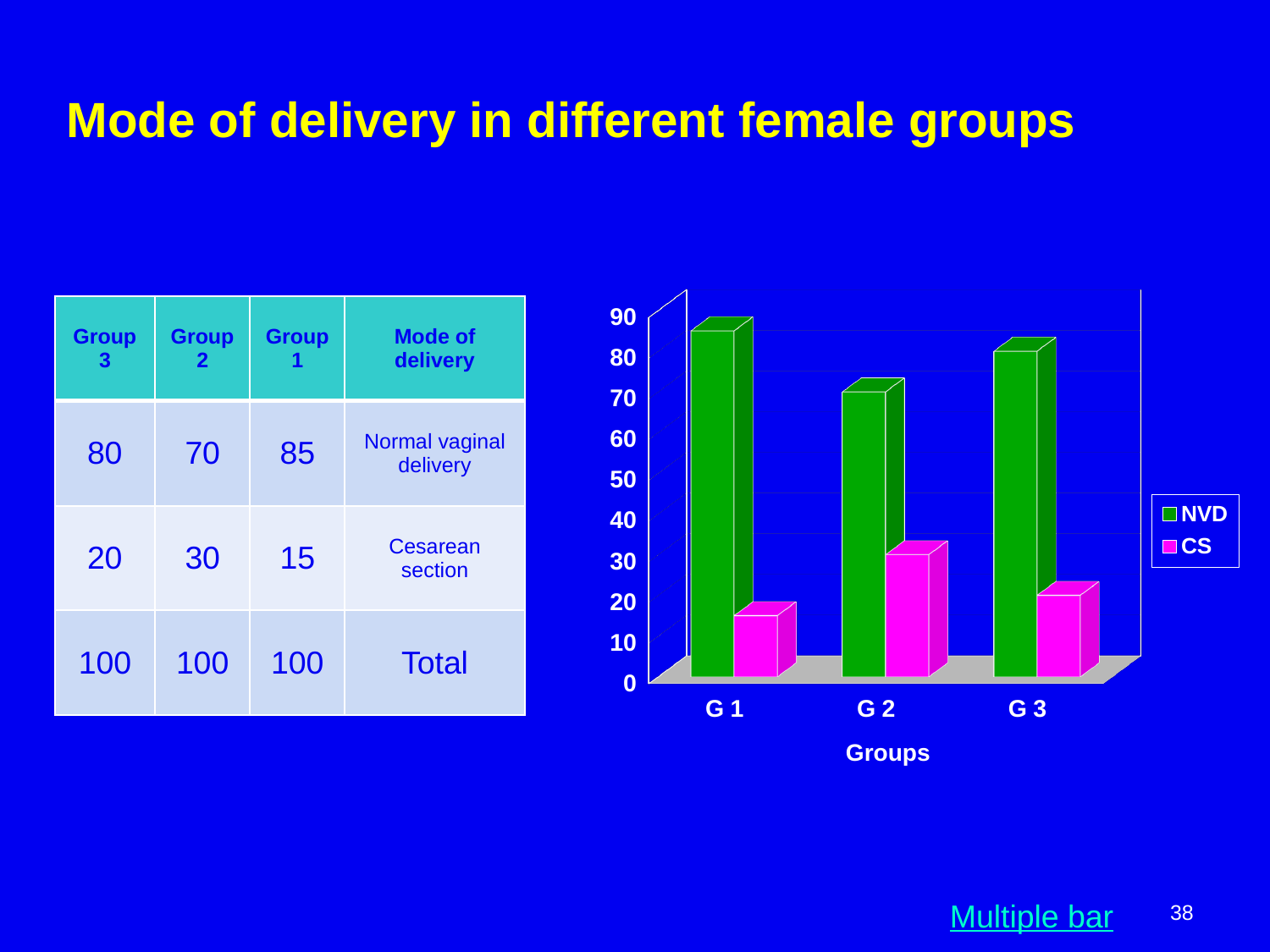
Which group has the lowest NVD value in the chart? G 2 How many groups are shown on the x axis of the chart? 3 What is the NVD value for G 2? 70 Which group has the highest CS value in the chart? G 2 Which group has the lowest CS value in the chart? G 1 What is the title of the x axis of the chart? Groups What kind of chart is shown on the slide? bar chart Is the NVD value for G 1 greater or less than 80? greater In group G 2, which is larger, NVD or CS? NVD Which group has the highest NVD value in the chart? G 1 Is the CS value for G 1 greater or less than 20? less How many series does the chart's legend list? 2